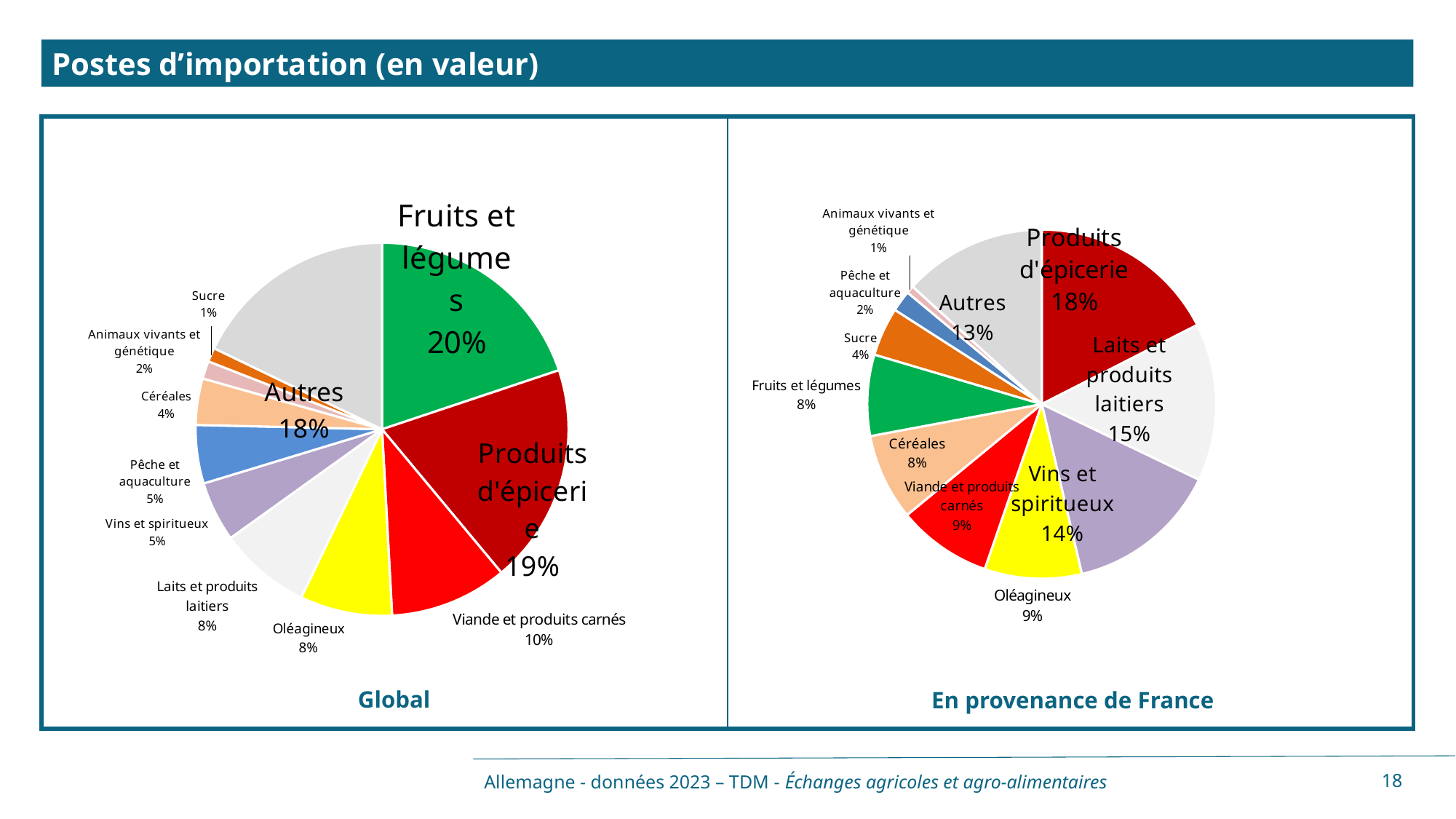
What type of chart is used on this slide? Pie chart In the 'En provenance de France' pie chart, which category has the largest share? Produits d'épicerie In the 'En provenance de France' pie chart, what share do Laits et produits laitiers represent? 15% In the 'Global' pie chart, what share do Viande et produits carnés represent? 10% In the 'En provenance de France' pie chart, what is the difference between the shares of Produits d'épicerie and Fruits et légumes? 10 percentage points In the 'Global' pie chart, what share do Fruits et légumes represent? 20% In the 'Global' pie chart, which category has the largest share? Fruits et légumes How many categories are shown in the 'Global' pie chart? 11 In the 'En provenance de France' pie chart, what share does Sucre represent? 4% In the 'En provenance de France' pie chart, which is larger: Vins et spiritueux or Céréales? Vins et spiritueux In the 'Global' pie chart, what is the difference between the shares of Produits d'épicerie and Oléagineux? 11 percentage points In the 'Global' pie chart, which category has the smallest share? Sucre